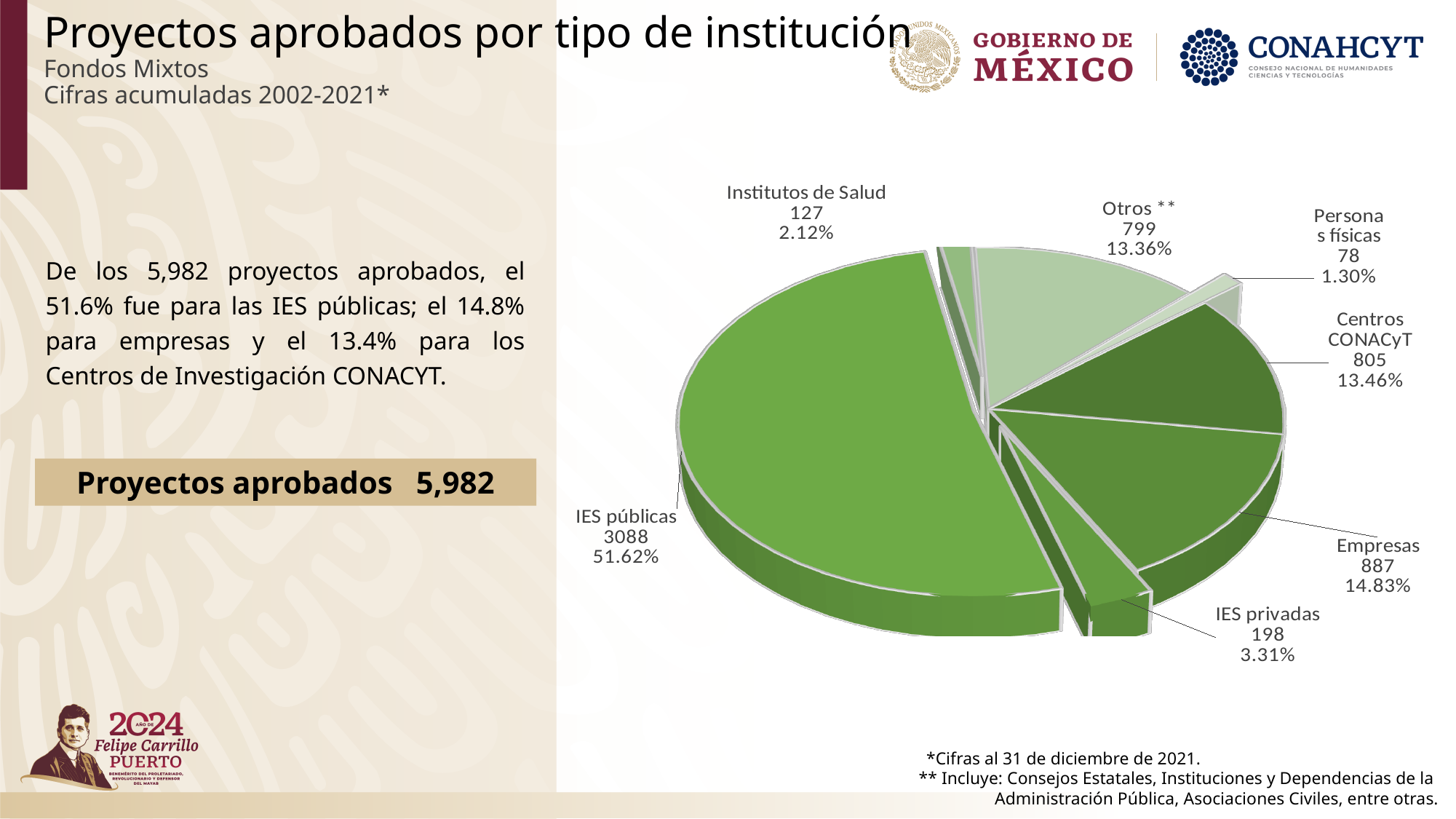
What is the title of the slide containing the pie chart? Proyectos aprobados por tipo de institución Which category has the largest slice of the pie? IES públicas How many categories does the pie chart show? 7 What kind of chart is shown on the slide? pie chart Which is larger, the value for Institutos de Salud or the value for IES privadas? IES privadas What is the value shown for Otros **? 799 Which category has the smallest slice of the pie? Personas físicas How many approved projects does the pie chart show for IES públicas? 3088 What percentage is shown for Personas físicas? 1.30% What is the value shown for Centros CONACyT? 805 What is the difference between the values for Empresas and IES privadas? 689 What share of the pie does Empresas represent? 14.83%